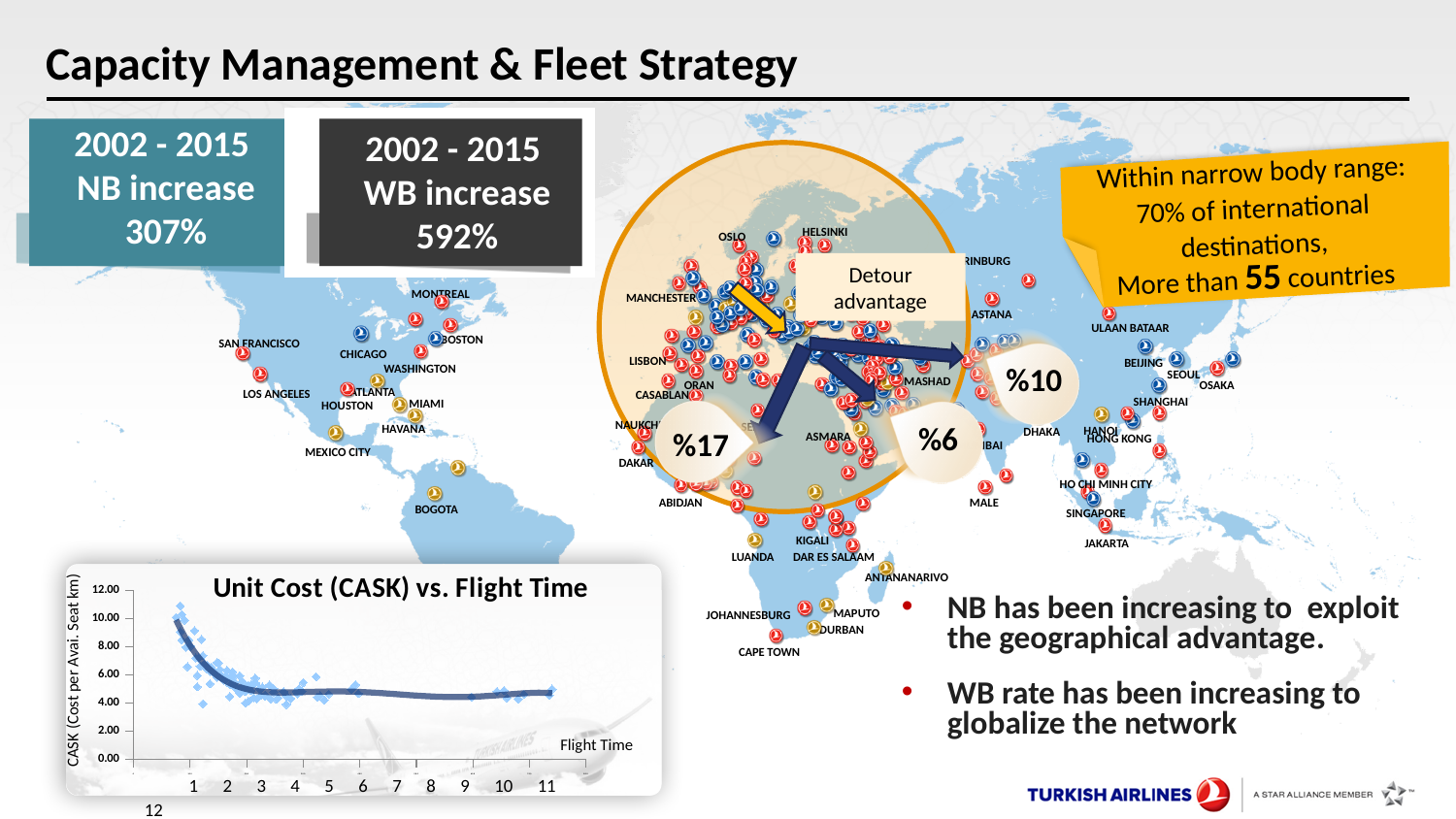
What is the title of the chart at the bottom left of the slide? Unit Cost (CASK) vs. Flight Time What is the label of the vertical axis on the 'Unit Cost (CASK) vs. Flight Time' chart? CASK (Cost per Avai. Seat km) In the 'Unit Cost (CASK) vs. Flight Time' chart, is the trend line value at flight time 1 greater or less than 8.00? greater In the 'Unit Cost (CASK) vs. Flight Time' chart, is the trend line higher at flight time 1 or at flight time 8? flight time 1 What is the highest value shown on the vertical axis of the 'Unit Cost (CASK) vs. Flight Time' chart? 12.00 In the 'Unit Cost (CASK) vs. Flight Time' chart, is the trend line value at flight time 6 greater or less than 8.00? less How many numbered flight-time ticks are shown on the horizontal axis of the 'Unit Cost (CASK) vs. Flight Time' chart? 11 In the 'Unit Cost (CASK) vs. Flight Time' chart, does CASK generally rise or fall as flight time increases from 1 to 3? fall In the 'Unit Cost (CASK) vs. Flight Time' chart, is the trend line value at flight time 10 greater or less than 6.00? less What kind of chart is the 'Unit Cost (CASK) vs. Flight Time' chart? scatter chart